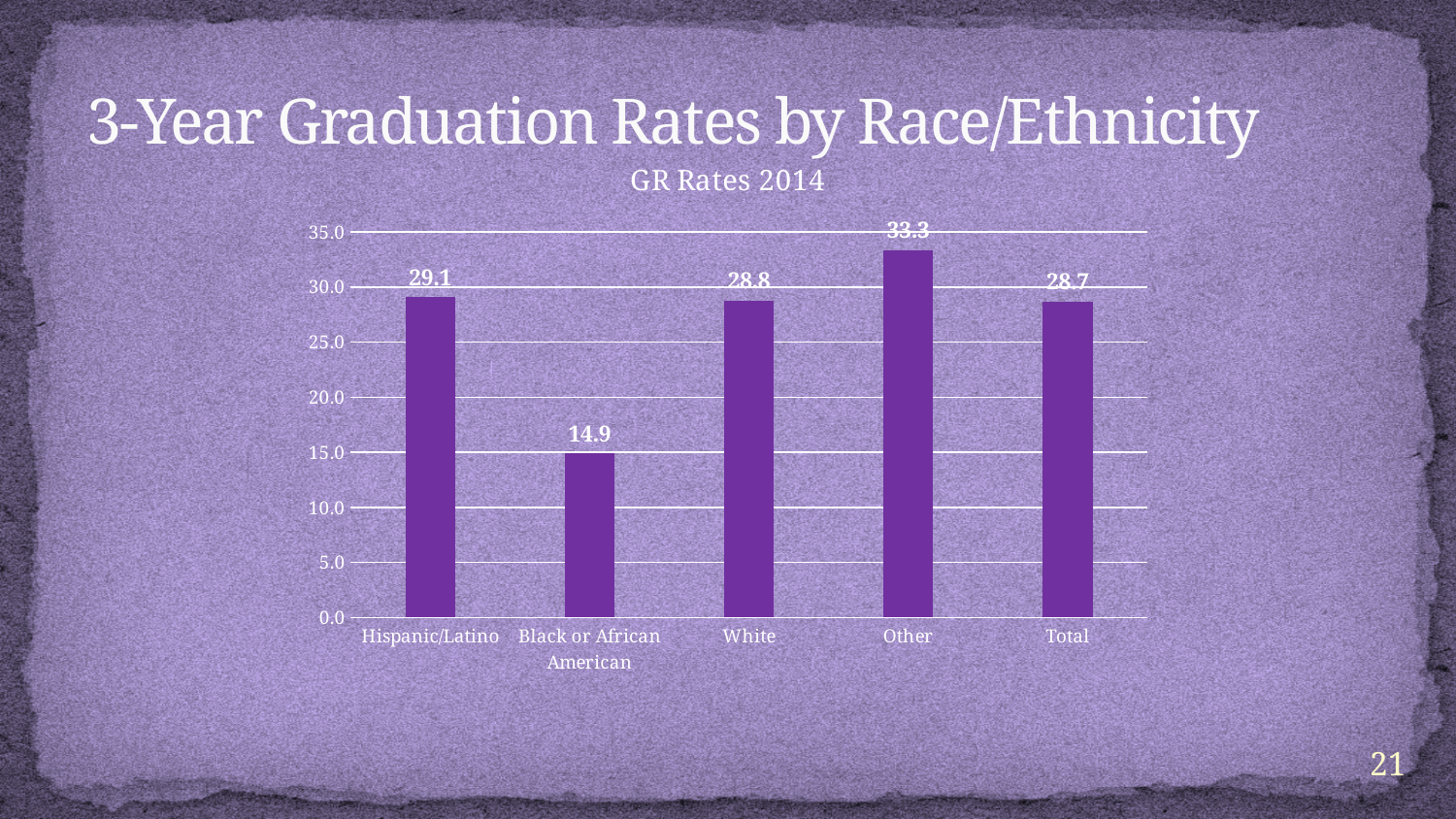
What is the GR rate for Total? 28.7 What is the title of the chart? GR Rates 2014 What is the GR rate for Black or African American? 14.9 What is the GR rate for Other? 33.3 How many categories are shown on the x axis? 5 What kind of chart is shown on the slide? Bar chart Which has a higher GR rate, Hispanic/Latino or Black or African American? Hispanic/Latino What is the GR rate for White? 28.8 Which category has the lowest GR rate? Black or African American What is the GR rate for Hispanic/Latino? 29.1 Which category has the highest GR rate? Other What is the difference between the GR rates for Other and Black or African American? 18.4